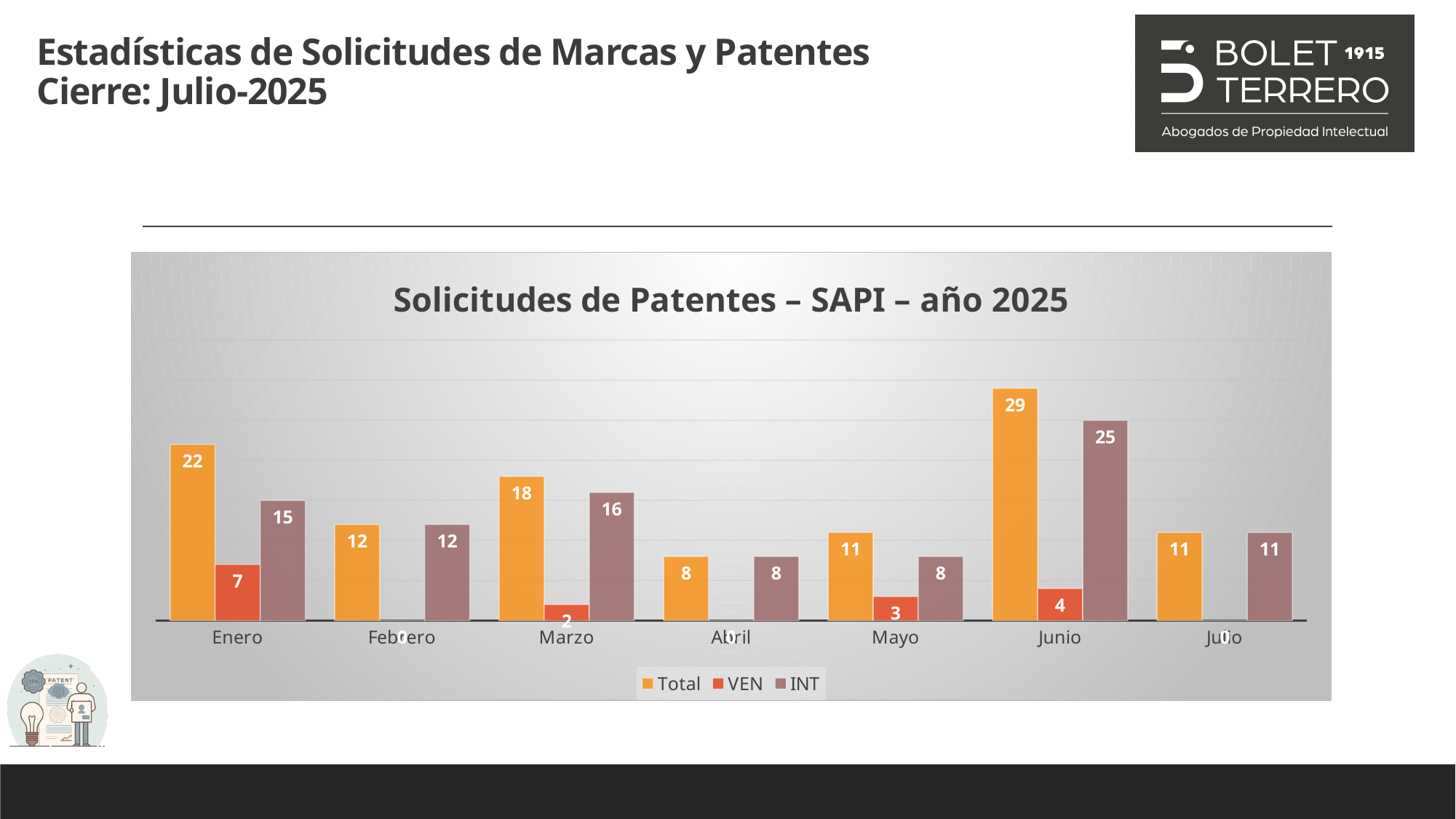
Which month has the highest Total value? Junio What is the Total value for Junio? 29 Which is larger, the INT value for Enero or the INT value for Febrero? INT value for Enero What kind of chart is shown on the slide? Bar chart What is the VEN value for Mayo? 3 Which month has the lowest Total value? Abril How many series does the legend list? 3 What is the INT value for Marzo? 16 What is the title of the chart? Solicitudes de Patentes – SAPI – año 2025 What is the difference between the Total value for Junio and the Total value for Enero? 7 What is the VEN value for Enero? 7 How many months are shown on the x axis? 7